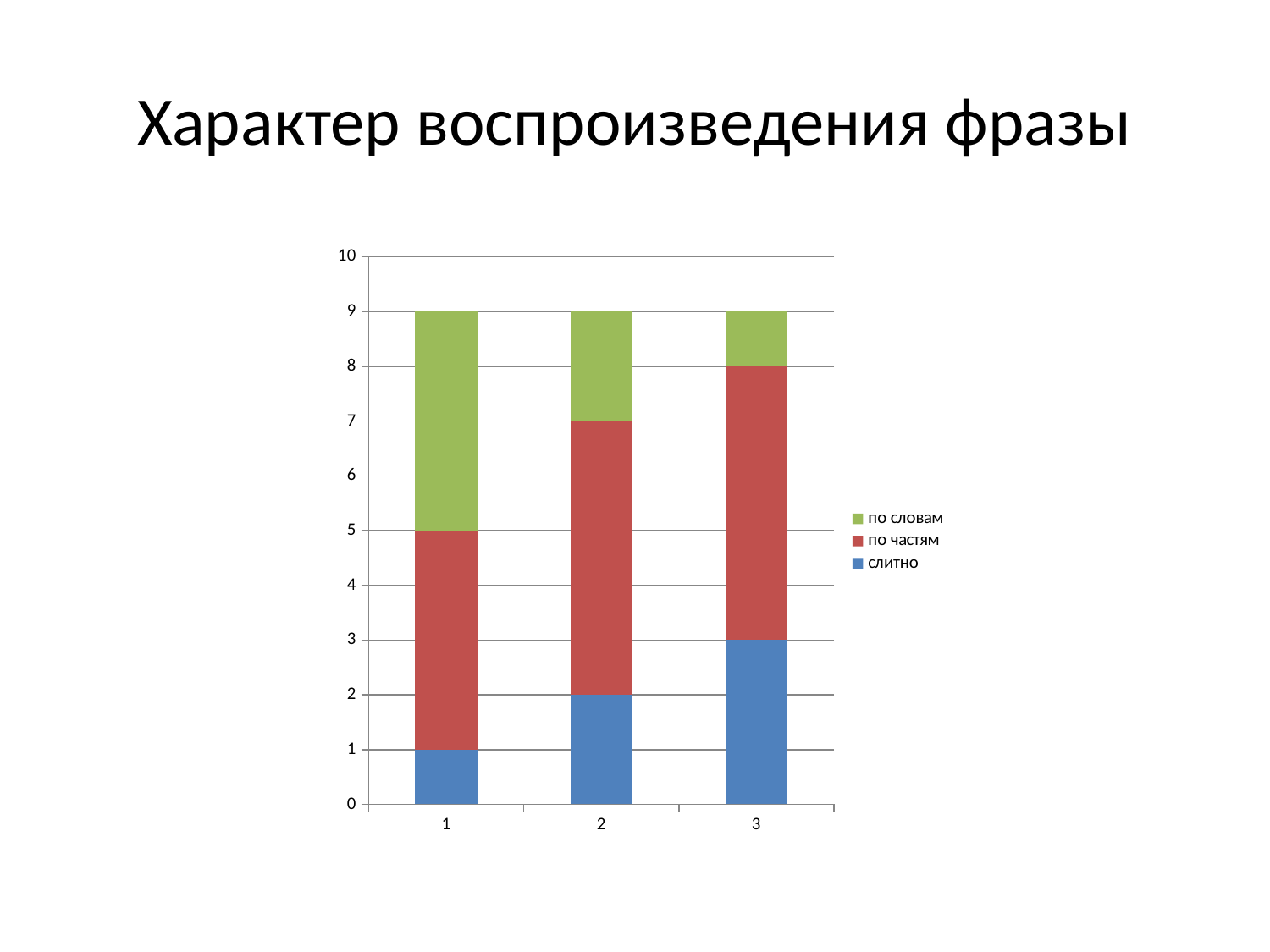
What is the difference between the 'слитно' values for category 3 and category 1? 2 Which category has the lowest value for the 'по словам' series? 3 What is the value of the 'слитно' series for category 1? 1 What is the value of the 'слитно' series for category 3? 3 How many series does the legend list? 3 Is the 'слитно' value for category 2 larger or smaller than the 'слитно' value for category 1? larger How many categories are shown on the x axis? 3 What is the total height of the stacked bar for category 2? 9 Does the 'слитно' series rise or fall from category 1 to category 3? rise What is the title of the chart on the slide? Характер воспроизведения фразы What kind of chart is shown on the slide? stacked bar chart Which category has the highest value for the 'слитно' series? 3